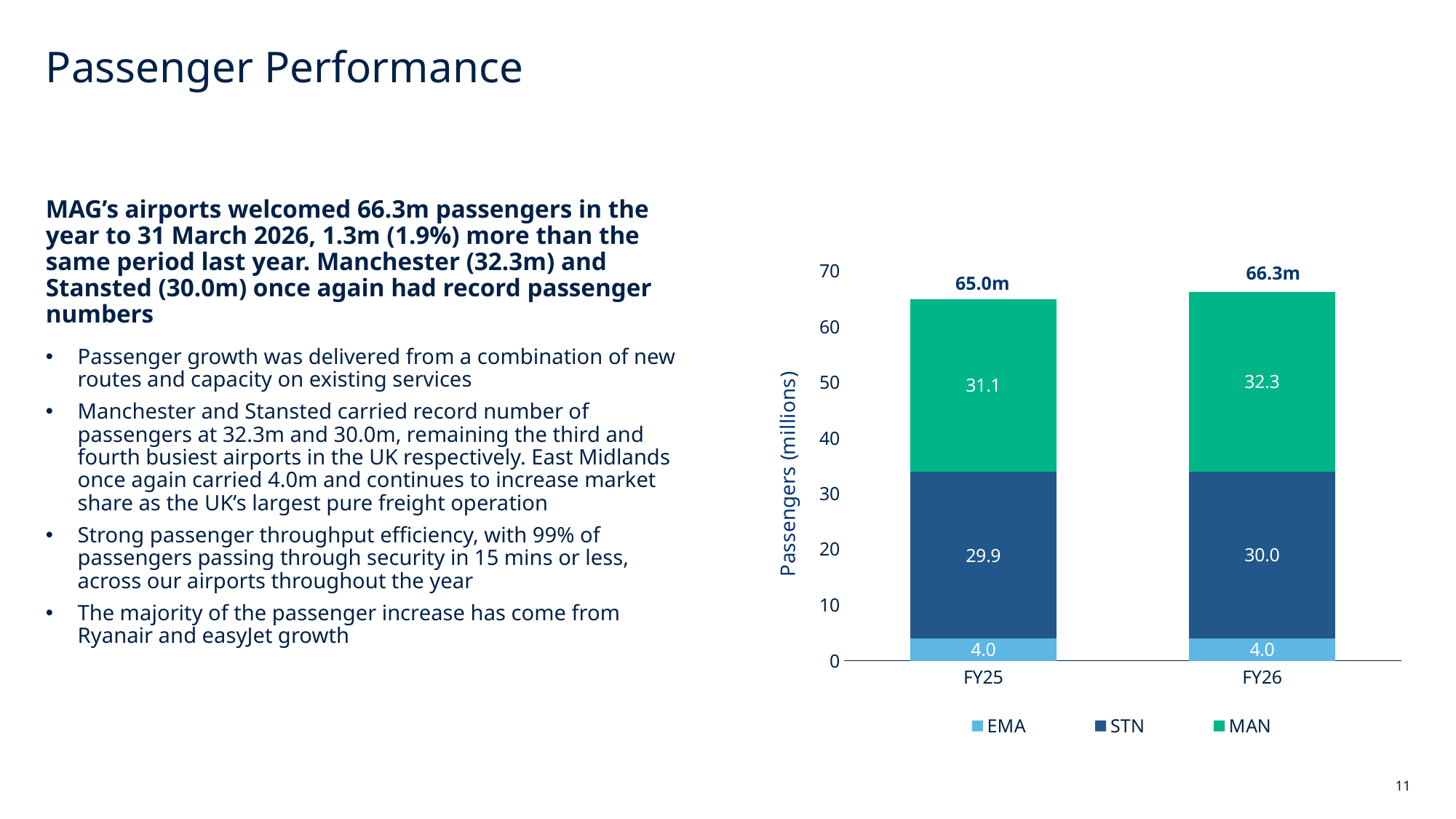
What is the MAN value for FY26? 32.3 What kind of chart is shown? Stacked bar chart What is the difference between the MAN values for FY26 and FY25? 1.2 What is the STN value for FY25? 29.9 How many series does the legend list? 3 Is the STN value for FY26 larger than the STN value for FY25? Yes Which series has the smallest value in FY25? EMA What is the total of the stacked bar for FY25? 65.0m What is the label on the vertical axis? Passengers (millions) What is the total of the stacked bar for FY26? 66.3m Which series has the largest value in FY26? MAN What is the EMA value for FY26? 4.0